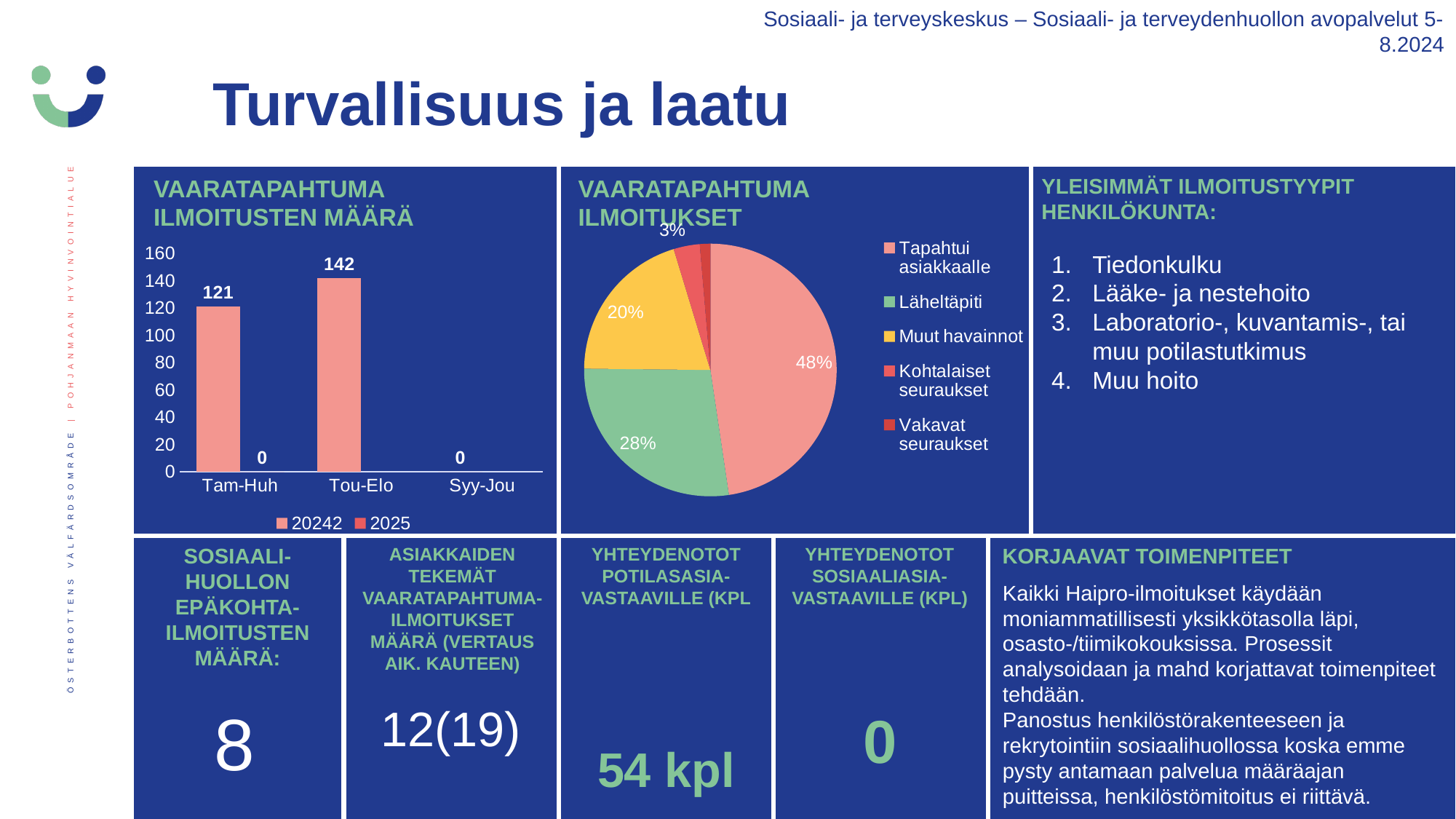
In the pie chart 'VAARATAPAHTUMA ILMOITUKSET', what share does 'Muut havainnot' have? 20% In the bar chart 'VAARATAPAHTUMA ILMOITUSTEN MÄÄRÄ', what is the value for Tou-Elo in the 2024 series? 142 What kind of chart is 'VAARATAPAHTUMA ILMOITUSTEN MÄÄRÄ'? Bar chart In the bar chart 'VAARATAPAHTUMA ILMOITUSTEN MÄÄRÄ', which period has the highest value? Tou-Elo In the pie chart 'VAARATAPAHTUMA ILMOITUKSET', what share does 'Läheltäpiti' have? 28% In the pie chart 'VAARATAPAHTUMA ILMOITUKSET', how many categories does the legend list? 5 In the bar chart 'VAARATAPAHTUMA ILMOITUSTEN MÄÄRÄ', what is the value for Tam-Huh in the 2024 series? 121 In the bar chart 'VAARATAPAHTUMA ILMOITUSTEN MÄÄRÄ', how many periods are shown on the x axis? 3 In the pie chart 'VAARATAPAHTUMA ILMOITUKSET', which category has the largest slice? Tapahtui asiakkaalle In the bar chart 'VAARATAPAHTUMA ILMOITUSTEN MÄÄRÄ', what is the difference between the Tou-Elo and Tam-Huh values in the 2024 series? 21 In the bar chart 'VAARATAPAHTUMA ILMOITUSTEN MÄÄRÄ', how many series does the legend list? 2 In the pie chart 'VAARATAPAHTUMA ILMOITUKSET', what share does 'Tapahtui asiakkaalle' have? 48%